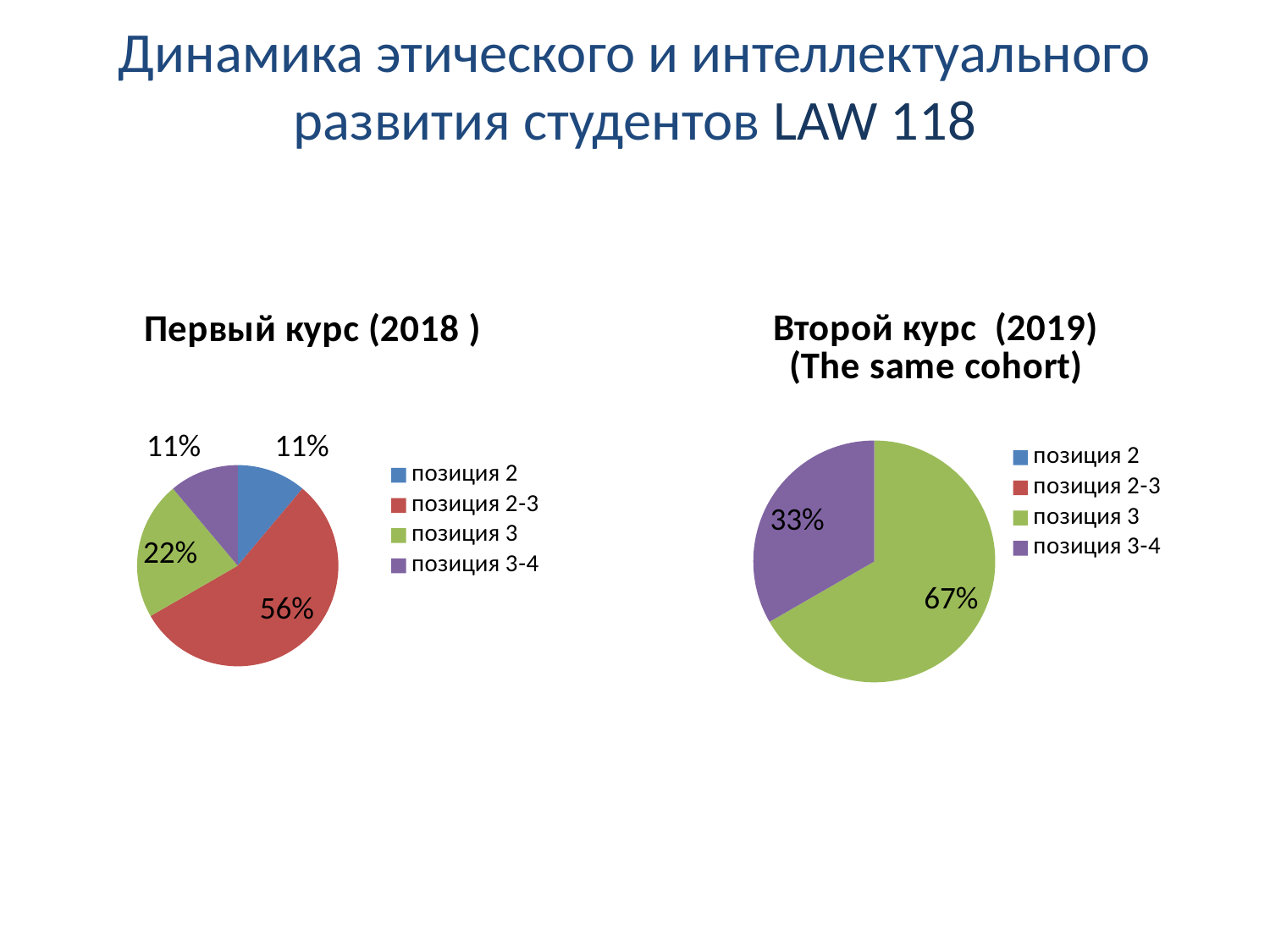
In the 'Первый курс (2018 )' chart, what is the difference between the shares of 'позиция 2-3' and 'позиция 3'? 34% In the 'Второй курс (2019)' chart, what is the difference between the shares of 'позиция 3' and 'позиция 3-4'? 34% In the 'Второй курс (2019)' chart, what share does 'позиция 3-4' have? 33% In the 'Второй курс (2019)' chart, which category has the largest slice? позиция 3 In the 'Первый курс (2018 )' chart, which category has the largest slice? позиция 2-3 How many entries does the legend of the 'Второй курс (2019)' chart list? 4 In the 'Второй курс (2019)' chart, what share does 'позиция 3' have? 67% In the 'Первый курс (2018 )' chart, what share does 'позиция 2-3' have? 56% What type of chart is used for 'Первый курс (2018 )'? Pie chart In the 'Первый курс (2018 )' chart, what colour is the 'позиция 2-3' slice? Red In the 'Первый курс (2018 )' chart, what share does 'позиция 3' have? 22% In the 'Первый курс (2018 )' chart, which is larger: 'позиция 3' or 'позиция 3-4'? позиция 3